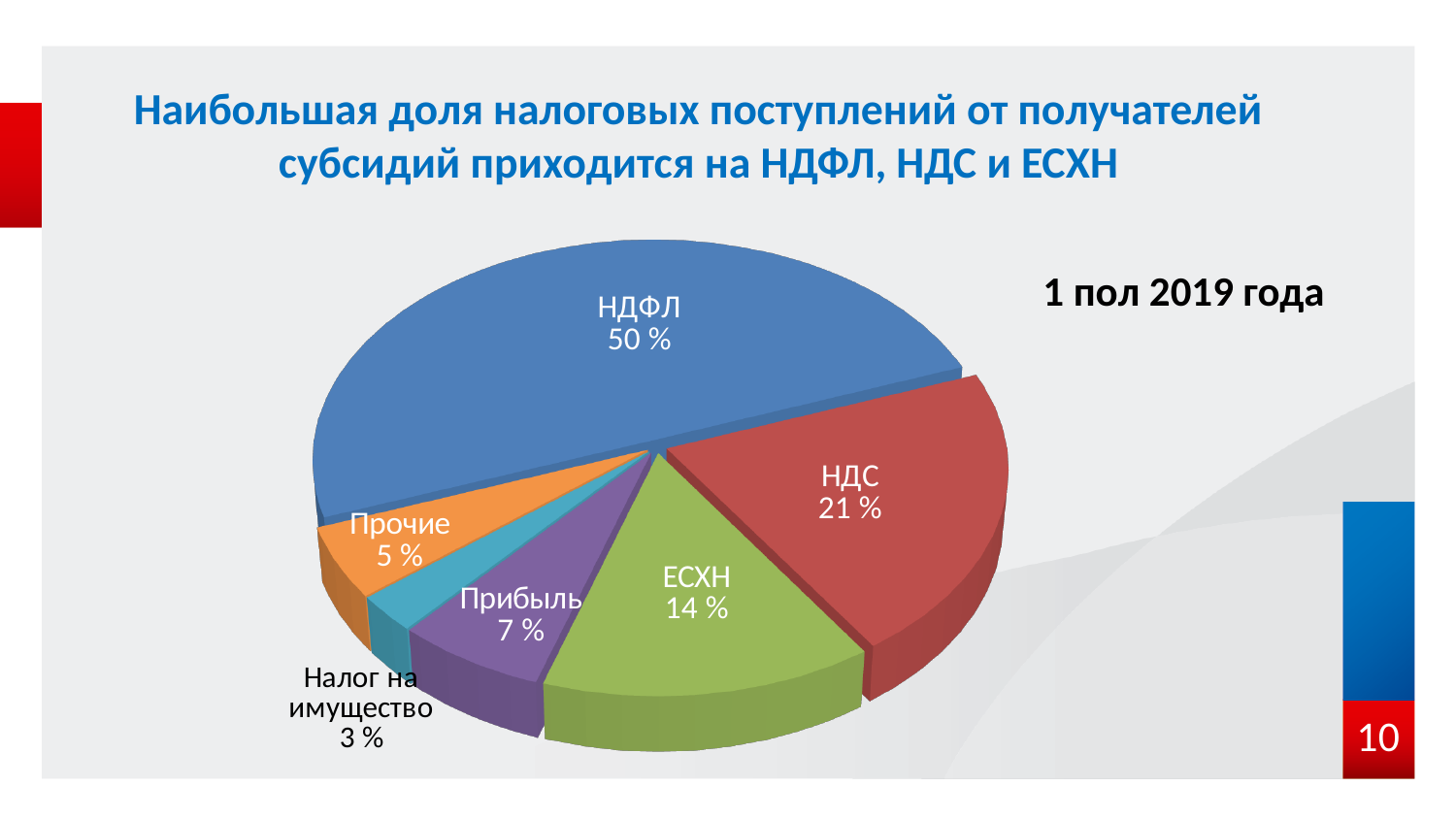
What share of the pie does НДФЛ account for? 50 % What is the difference in percentage points between НДС and ЕСХН? 7 What is the value shown for Налог на имущество? 3 % What is the value shown for ЕСХН? 14 % What colour is the НДС slice? Red How many slices does the pie chart have? 6 Which category has the largest slice of the pie? НДФЛ Which category has the smallest slice of the pie? Налог на имущество What period does the chart refer to, according to the label next to it? 1 пол 2019 года What kind of chart is shown on the slide? Pie chart Which is larger, the slice for Прибыль or the slice for Прочие? Прибыль What is the value shown for НДС? 21 %